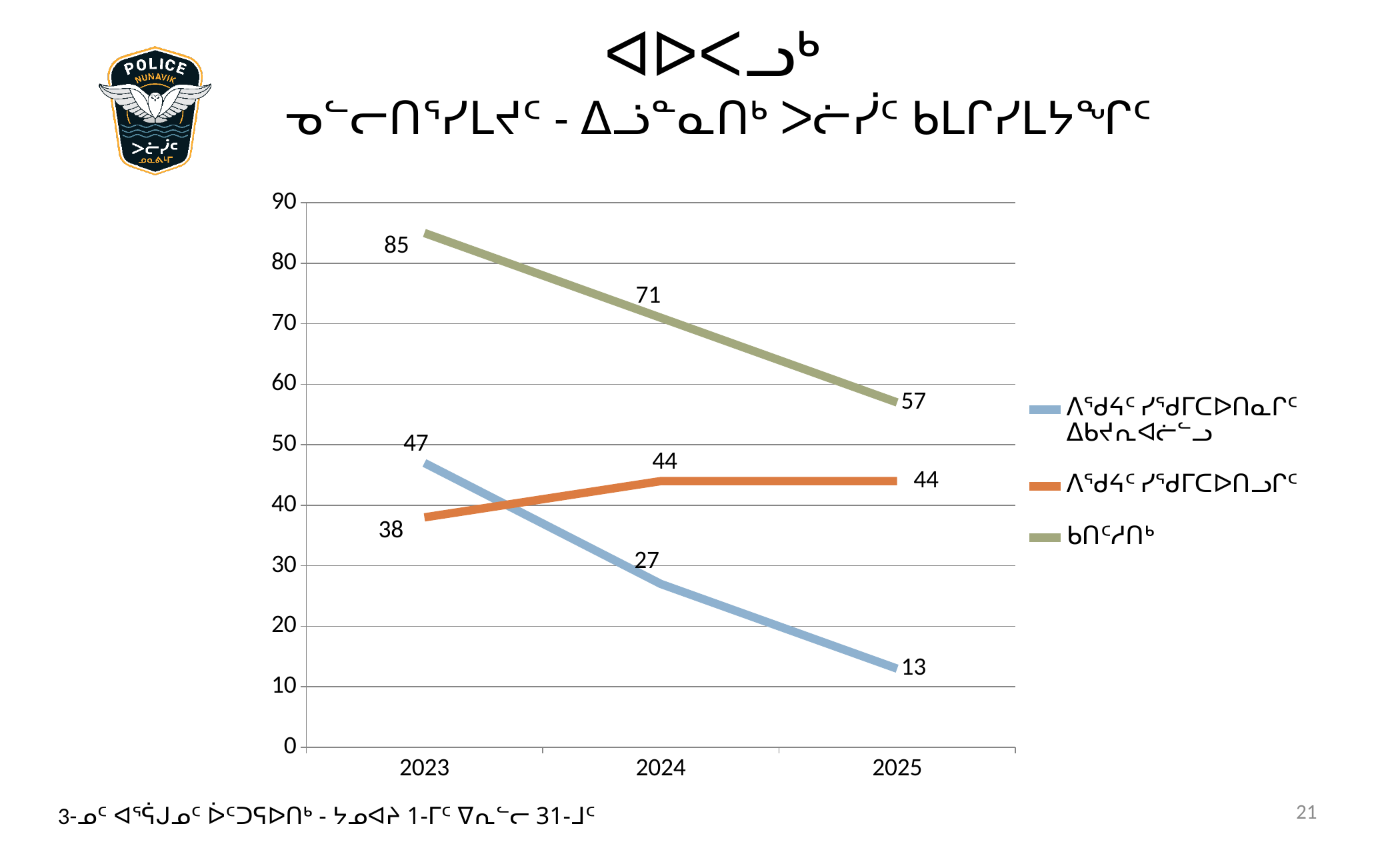
What type of chart is shown on the slide? line chart What is the value of the blue line in 2025? 13 What is the difference between the blue line's values in 2023 and 2024? 20 What is the value of the orange line in 2024? 44 Does the blue line rise or fall from 2023 to 2025? fall What is the value of the green line in 2023? 85 How many series does the legend list? 3 In 2025, which is larger: the orange line or the blue line? the orange line By how much did the green line decrease from 2023 to 2025? 28 What is the value of the orange line in 2023? 38 In which year does the green line reach its highest value? 2023 How many years are shown on the x axis? 3